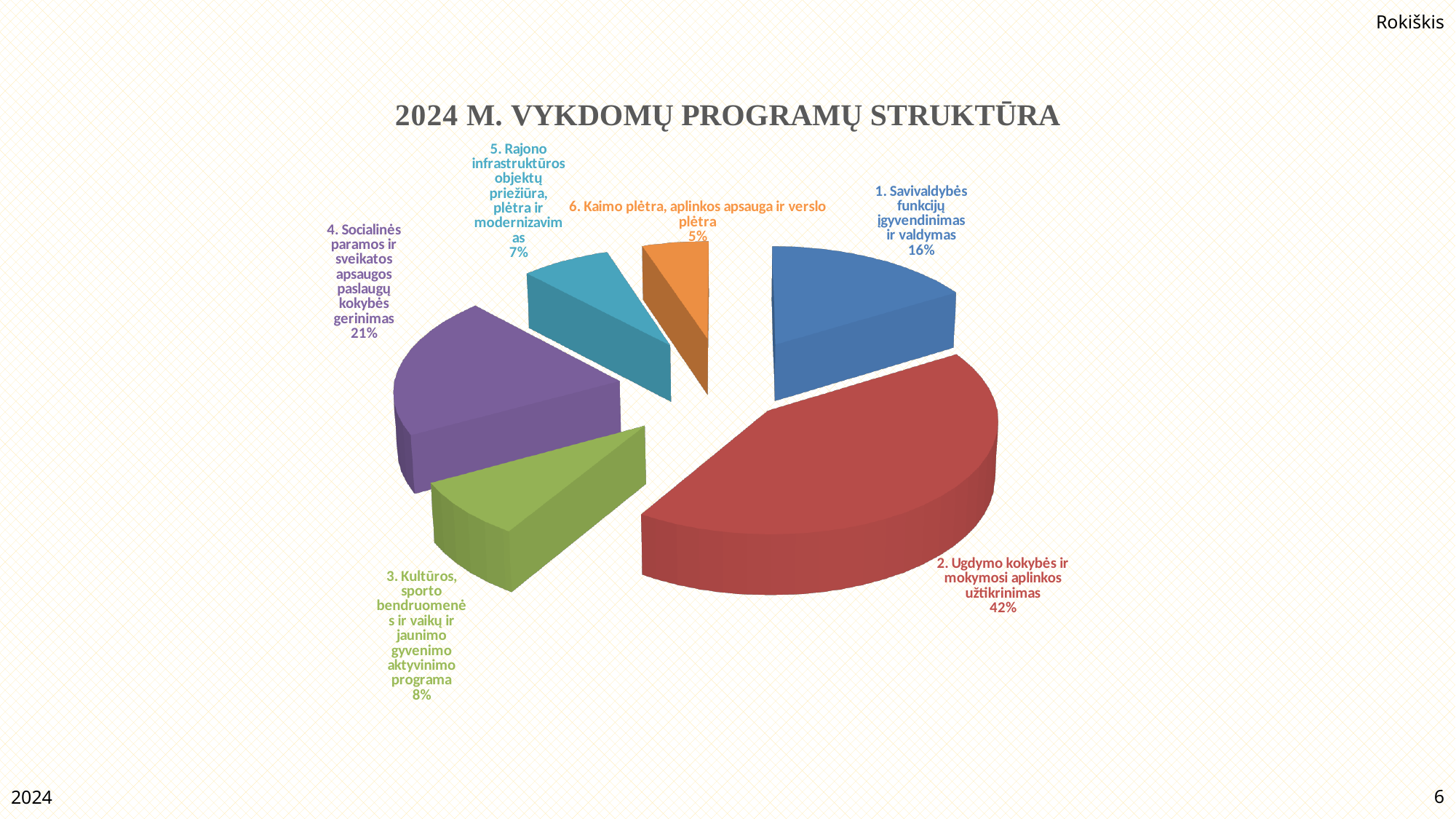
What type of chart is shown on the slide? Pie chart What share of the pie is "2. Ugdymo kokybės ir mokymosi aplinkos užtikrinimas"? 42% How many slices does the pie chart have? 6 What is the title of the chart? 2024 M. VYKDOMŲ PROGRAMŲ STRUKTŪRA What share of the pie is "6. Kaimo plėtra, aplinkos apsauga ir verslo plėtra"? 5% What is the difference in percentage points between the share of program 2 (Ugdymo kokybės ir mokymosi aplinkos užtikrinimas) and program 4 (Socialinės paramos ir sveikatos apsaugos paslaugų kokybės gerinimas)? 21 percentage points Which program has the largest share of the pie? 2. Ugdymo kokybės ir mokymosi aplinkos užtikrinimas Which has a larger share: program 3 (Kultūros, sporto bendruomenės ir vaikų ir jaunimo gyvenimo aktyvinimo programa) or program 1 (Savivaldybės funkcijų įgyvendinimas ir valdymas)? 1. Savivaldybės funkcijų įgyvendinimas ir valdymas What share of the pie is "5. Rajono infrastruktūros objektų priežiūra, plėtra ir modernizavimas"? 7% Which program has the smallest share of the pie? 6. Kaimo plėtra, aplinkos apsauga ir verslo plėtra